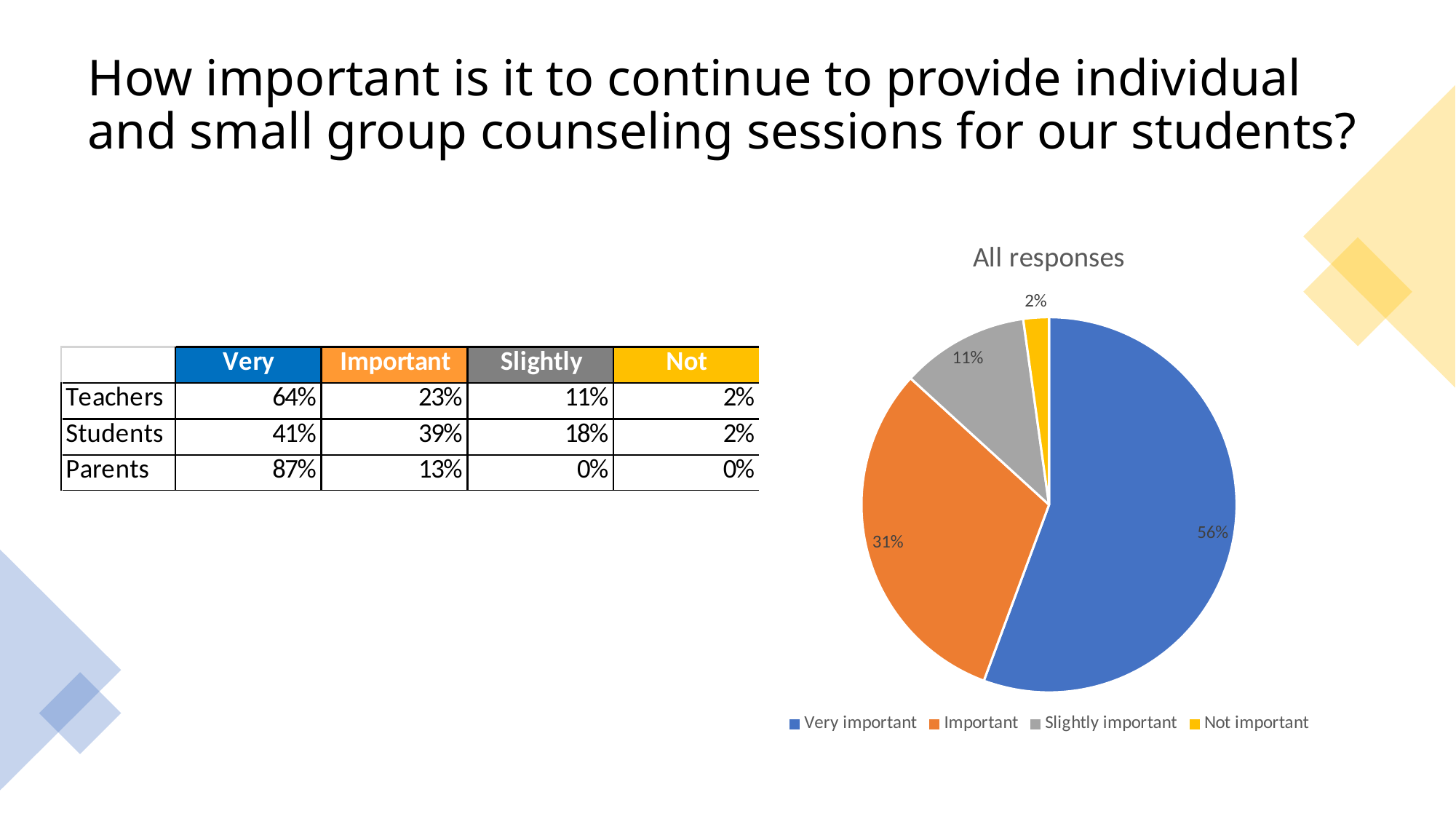
How many slices does the pie chart have? 4 What share of the pie chart is Important? 31% What share of the pie chart is Very important? 56% What kind of chart is shown on the slide? pie chart How many entries does the pie chart's legend list? 4 Which is larger in the pie chart, Important or Slightly important? Important What is the title of the pie chart? All responses What share of the pie chart is Not important? 2% Which category has the largest slice in the pie chart? Very important What is the difference between the Very important and Important shares in the pie chart? 25% Which category has the smallest slice in the pie chart? Not important